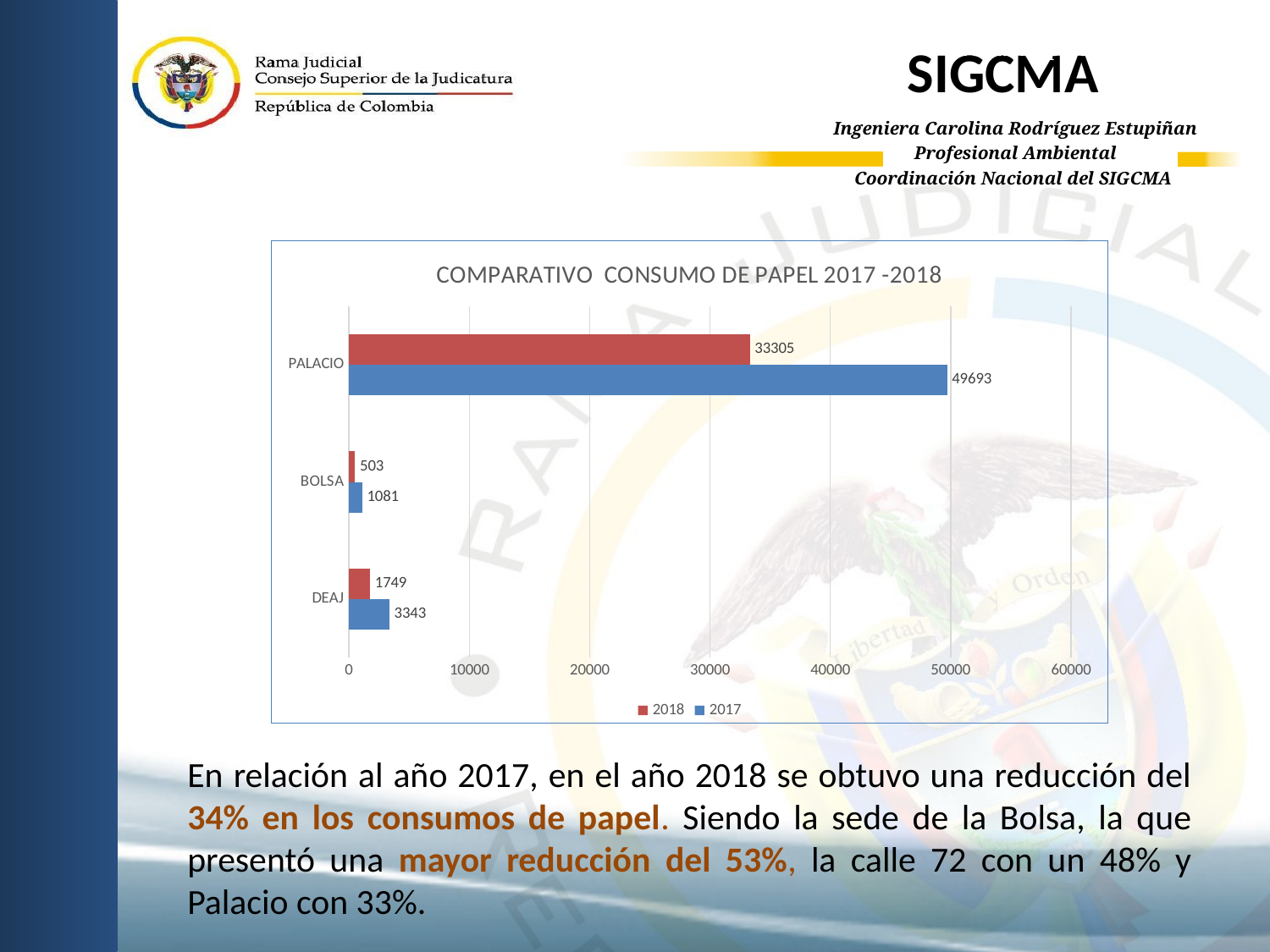
What is the difference between the 2017 and 2018 values for DEAJ? 1594 How many series does the legend list? 2 How many categories are shown on the chart? 3 Which category has the lowest 2018 value? BOLSA Which is larger for BOLSA, the 2017 value or the 2018 value? 2017 What type of chart is shown on the slide? Bar chart What is the 2018 paper consumption value for PALACIO? 33305 What is the 2017 paper consumption value for BOLSA? 1081 What is the difference between the 2017 and 2018 values for PALACIO? 16388 Is the 2017 value for PALACIO greater or less than 40000? greater Which category has the highest 2017 value? PALACIO What is the 2018 value for DEAJ? 1749